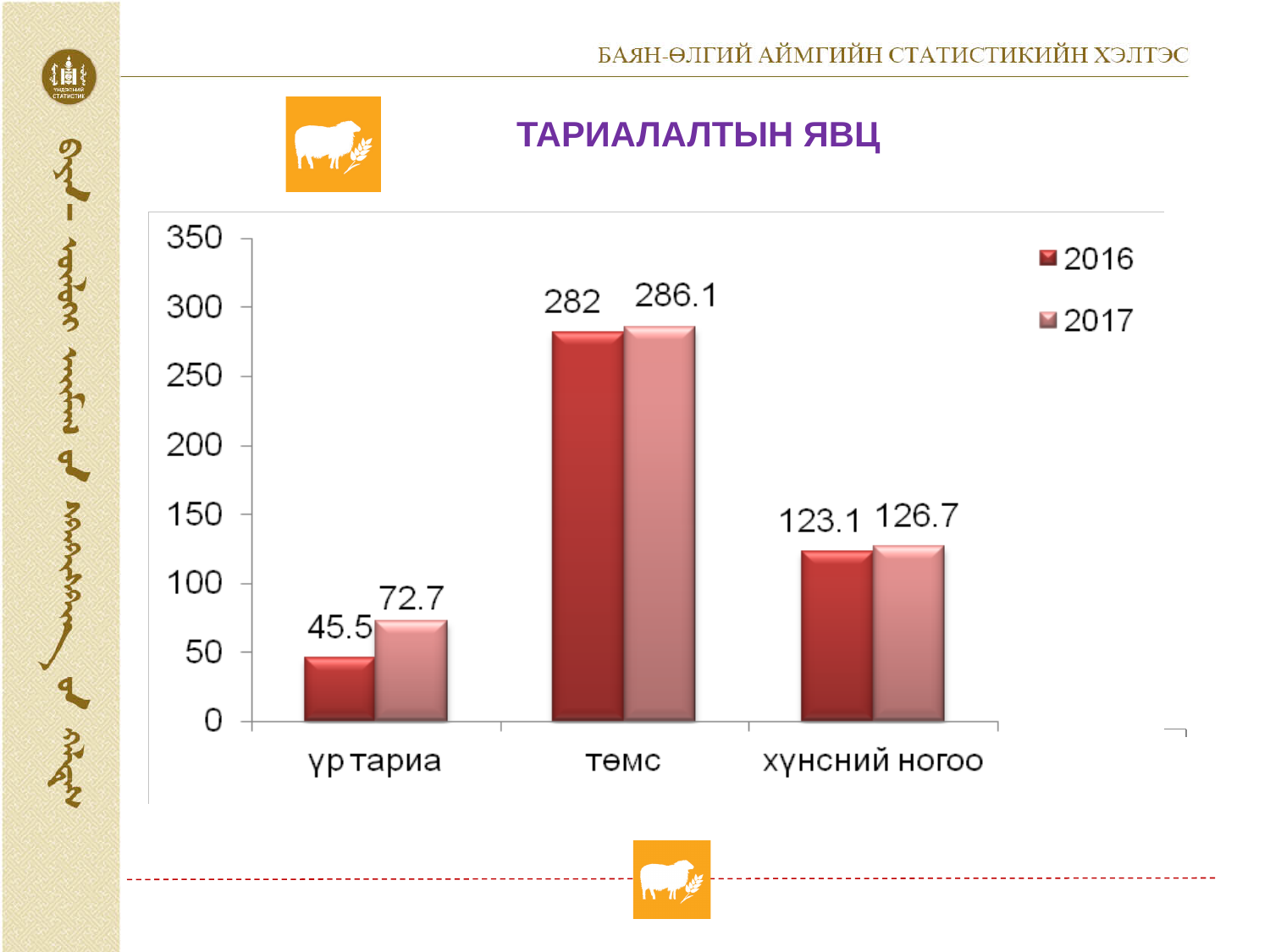
Which category has the lowest 2017 value? үр тариа What is the difference between the 2017 and 2016 values for төмс? 4.1 How many categories are shown on the x axis? 3 What is the difference between the 2017 and 2016 values for үр тариа? 27.2 How many series does the legend list? 2 What is the 2017 value for төмс? 286.1 What kind of chart is shown on the slide? bar chart Is the 2016 value for төмс greater or less than 250? greater Which category has the highest 2016 value? төмс Which is larger: the 2016 value for хүнсний ногоо or the 2017 value for үр тариа? 2016 value for хүнсний ногоо What is the 2016 value for үр тариа? 45.5 What is the 2017 value for хүнсний ногоо? 126.7